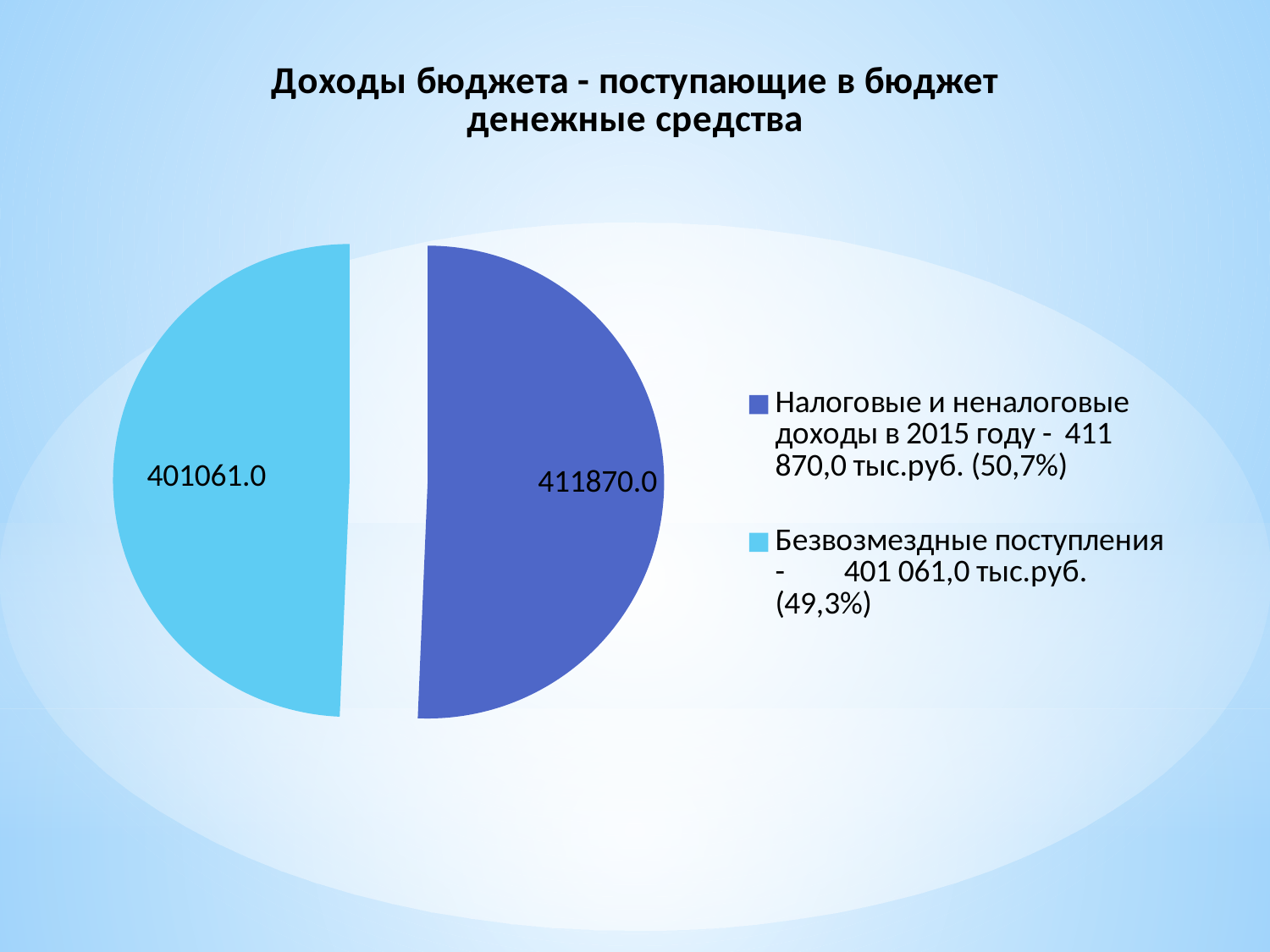
How many slices does the pie chart have? 2 What is the total of the two slice values? 812931.0 What is the value shown for the slice 'Налоговые и неналоговые доходы в 2015 году'? 411870.0 Which slice has the largest value? Налоговые и неналоговые доходы в 2015 году Which slice has the smallest value? Безвозмездные поступления What is the value shown for the slice 'Безвозмездные поступления'? 401061.0 How many entries does the legend list? 2 What is the difference between the values of the two slices? 10809.0 What share of the pie does 'Безвозмездные поступления' represent, according to the legend? 49,3% What kind of chart is shown on the slide? Pie chart Which is larger: 'Налоговые и неналоговые доходы' or 'Безвозмездные поступления'? Налоговые и неналоговые доходы What colour is the slice for 'Налоговые и неналоговые доходы в 2015 году'? Dark blue